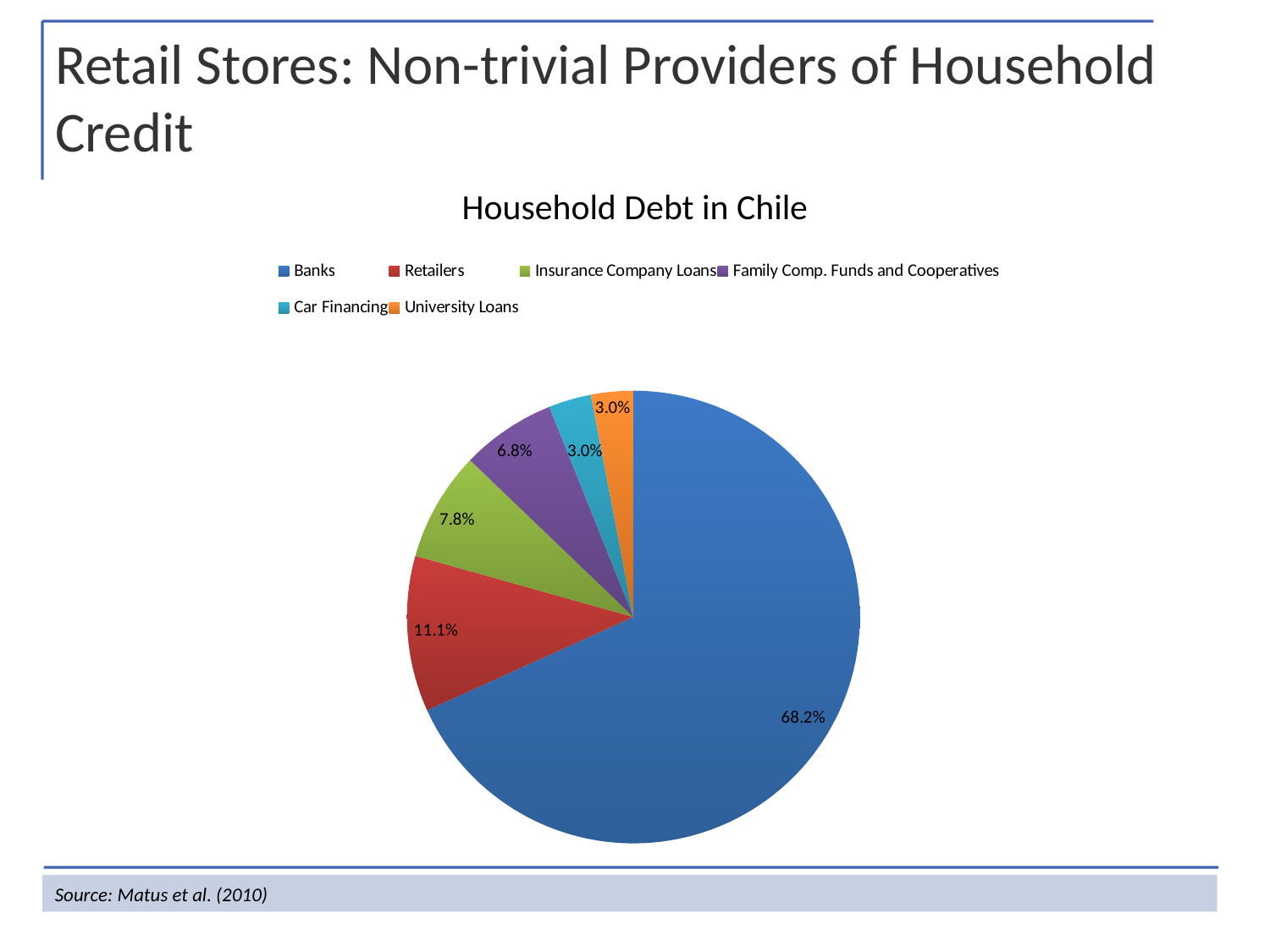
What is the difference in percentage points between the Banks share and the Retailers share? 57.1 How many categories does the legend of the pie chart list? 6 What share of household debt in Chile is attributed to University Loans? 3.0% What share of household debt in Chile is attributed to Retailers? 11.1% What share of household debt in Chile is attributed to Insurance Company Loans? 7.8% Which is larger, the share for Retailers or the share for Insurance Company Loans? Retailers What share of household debt in Chile is attributed to Banks? 68.2% Which category has the largest share of household debt in Chile? Banks What colour is the slice representing Retailers? Red What is the title of the chart? Household Debt in Chile What share of household debt in Chile is attributed to Family Comp. Funds and Cooperatives? 6.8% What type of chart is shown on the slide? Pie chart